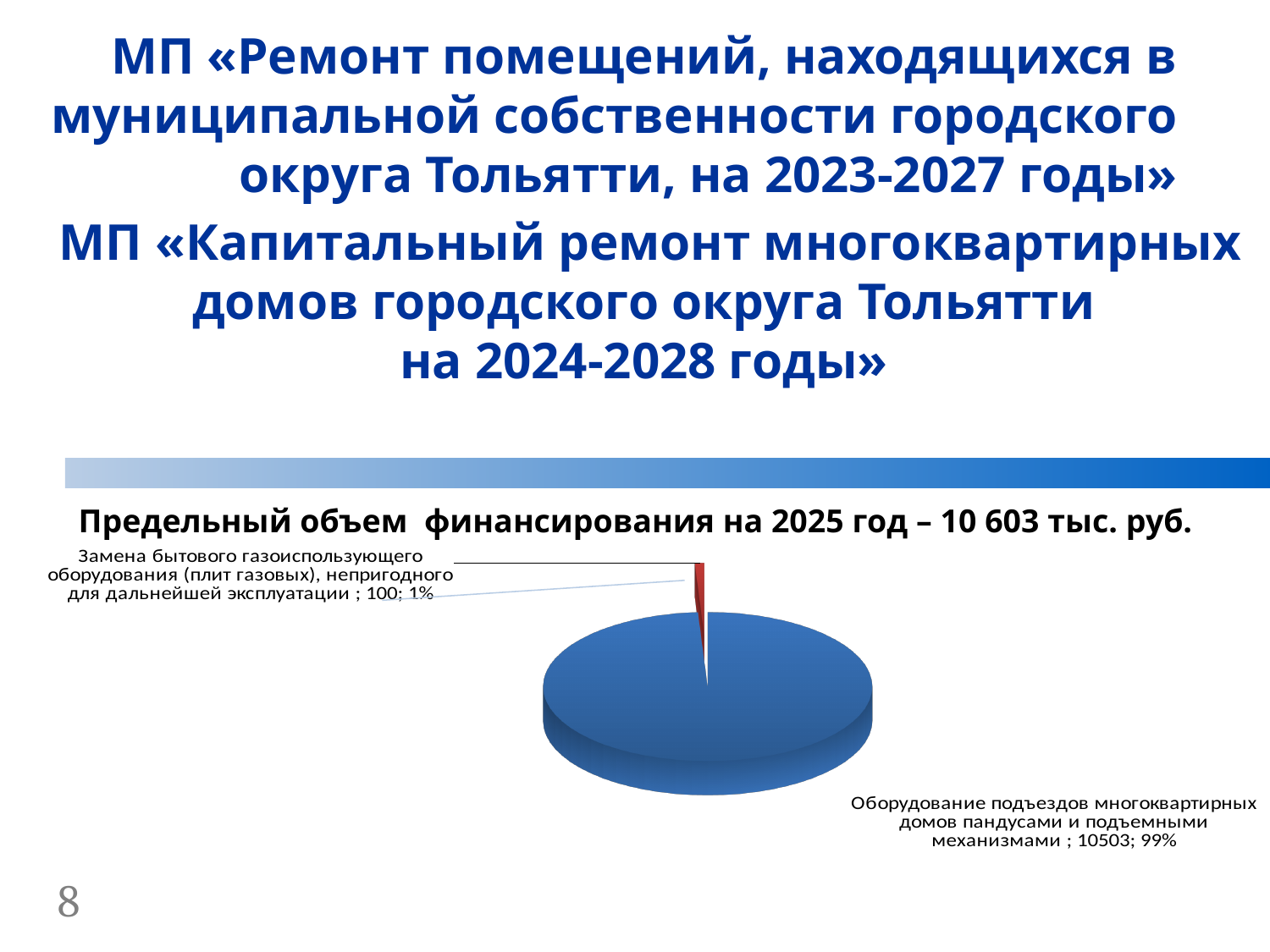
How many slices does the pie chart have? 2 Which category has the smallest slice of the pie? Замена бытового газоиспользующего оборудования (плит газовых), непригодного для дальнейшей эксплуатации What is the value for «Замена бытового газоиспользующего оборудования (плит газовых), непригодного для дальнейшей эксплуатации»? 100 What kind of chart is shown on the slide? pie chart What is the difference between the value for «Оборудование подъездов многоквартирных домов пандусами и подъемными механизмами» and the value for «Замена бытового газоиспользующего оборудования»? 10403 What is the total of the two pie slice values? 10603 What is the value for «Оборудование подъездов многоквартирных домов пандусами и подъемными механизмами»? 10503 What colour is the slice for «Замена бытового газоиспользующего оборудования (плит газовых)»? red Which is larger: the value for «Оборудование подъездов многоквартирных домов пандусами и подъемными механизмами» or the value for «Замена бытового газоиспользующего оборудования»? Оборудование подъездов многоквартирных домов пандусами и подъемными механизмами Which category has the largest slice of the pie? Оборудование подъездов многоквартирных домов пандусами и подъемными механизмами What share of the pie does «Оборудование подъездов многоквартирных домов пандусами и подъемными механизмами» take? 99% What share of the pie does «Замена бытового газоиспользующего оборудования (плит газовых)» take? 1%